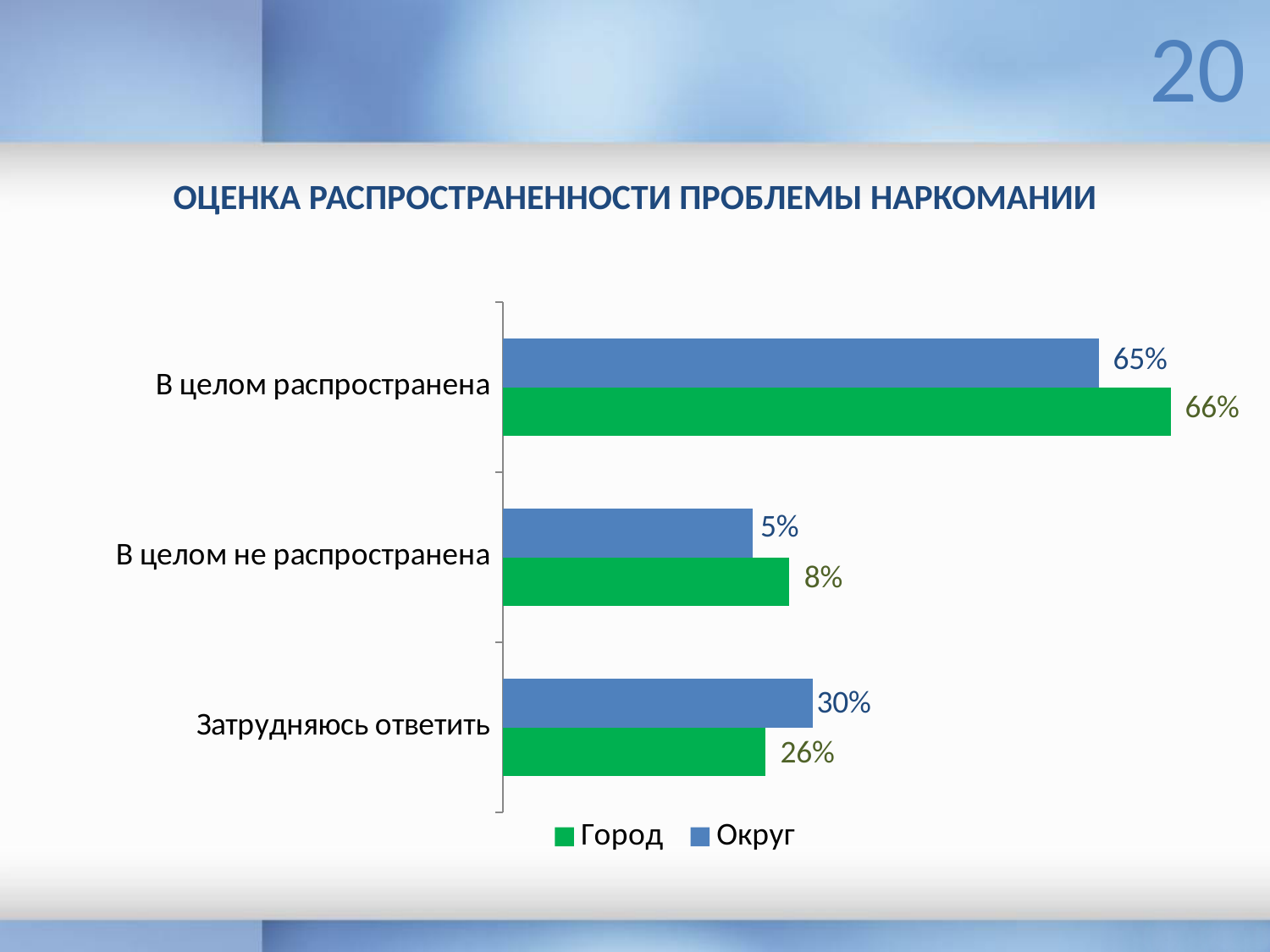
What is the title of the chart? ОЦЕНКА РАСПРОСТРАНЕННОСТИ ПРОБЛЕМЫ НАРКОМАНИИ What is the difference between the Город and Округ values for 'В целом не распространена'? 3% What is the value for Округ in the category 'В целом не распространена'? 5% What is the difference between the Округ and Город values for 'Затрудняюсь ответить'? 4% How many series does the legend list? 2 How many categories are shown on the chart? 3 What is the value for Город in the category 'В целом распространена'? 66% Which category has the highest value for Город? В целом распространена For 'Затрудняюсь ответить', which series has the larger value, Город or Округ? Округ What kind of chart is shown on the slide? Bar chart Which category has the lowest value for Округ? В целом не распространена What is the value for Округ in the category 'Затрудняюсь ответить'? 30%